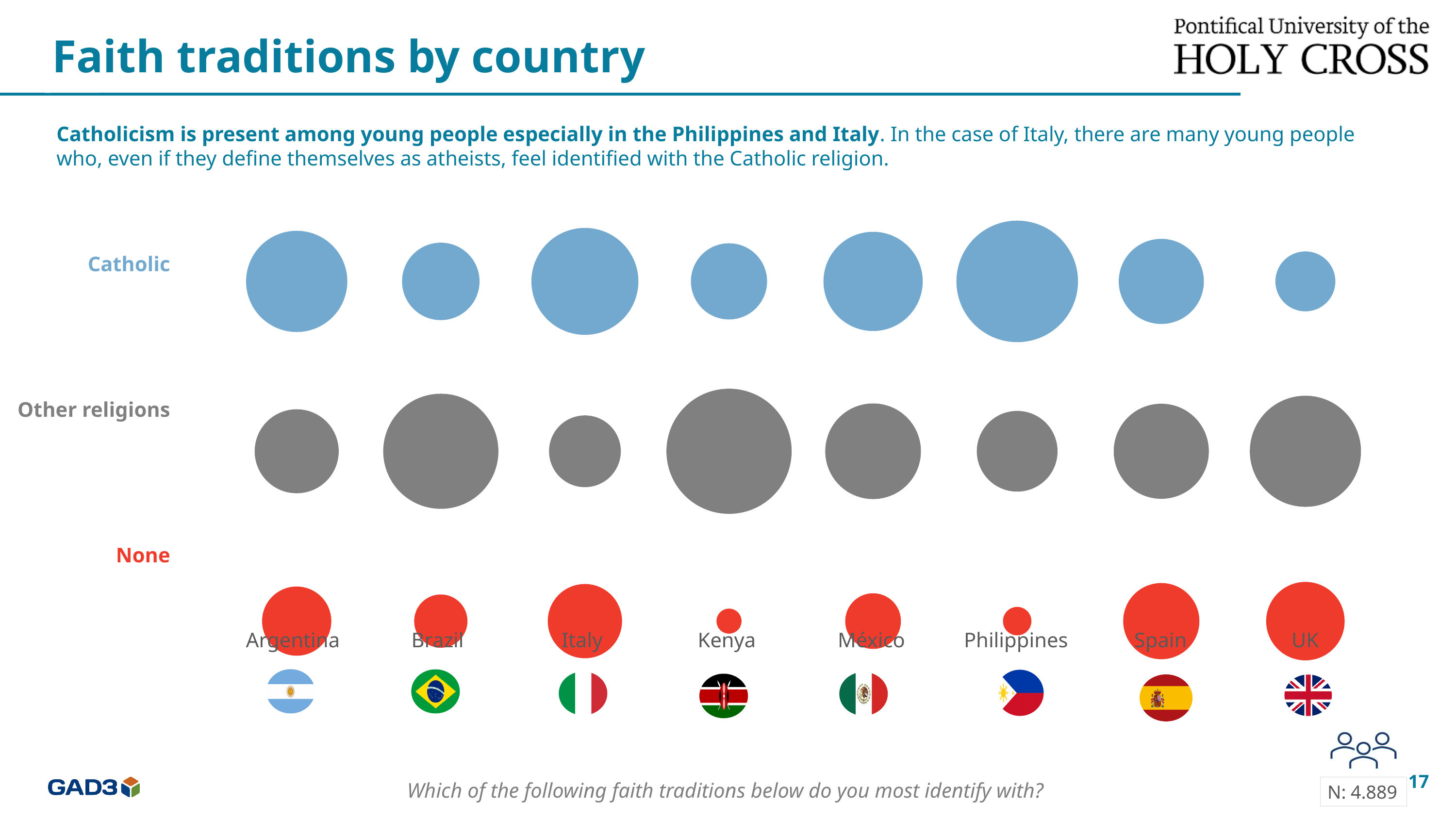
In the Catholic row, which bubble is larger: Italy or Kenya? Italy What kind of chart is shown on the slide? Bubble chart Which country has the largest bubble in the Other religions row? Kenya What colour are the bubbles in the None row? Red How many countries are shown along the bottom of the chart? 8 In the Other religions row, which bubble is larger: Brazil or Italy? Brazil How many faith-tradition categories (rows) does the chart show? 3 Which country has the smallest bubble in the Other religions row? Italy Which country has the largest bubble in the Catholic row? Philippines What is the title of the chart on the slide? Faith traditions by country Which country has the smallest bubble in the Catholic row? UK In the None row, which bubble is larger: Spain or Kenya? Spain